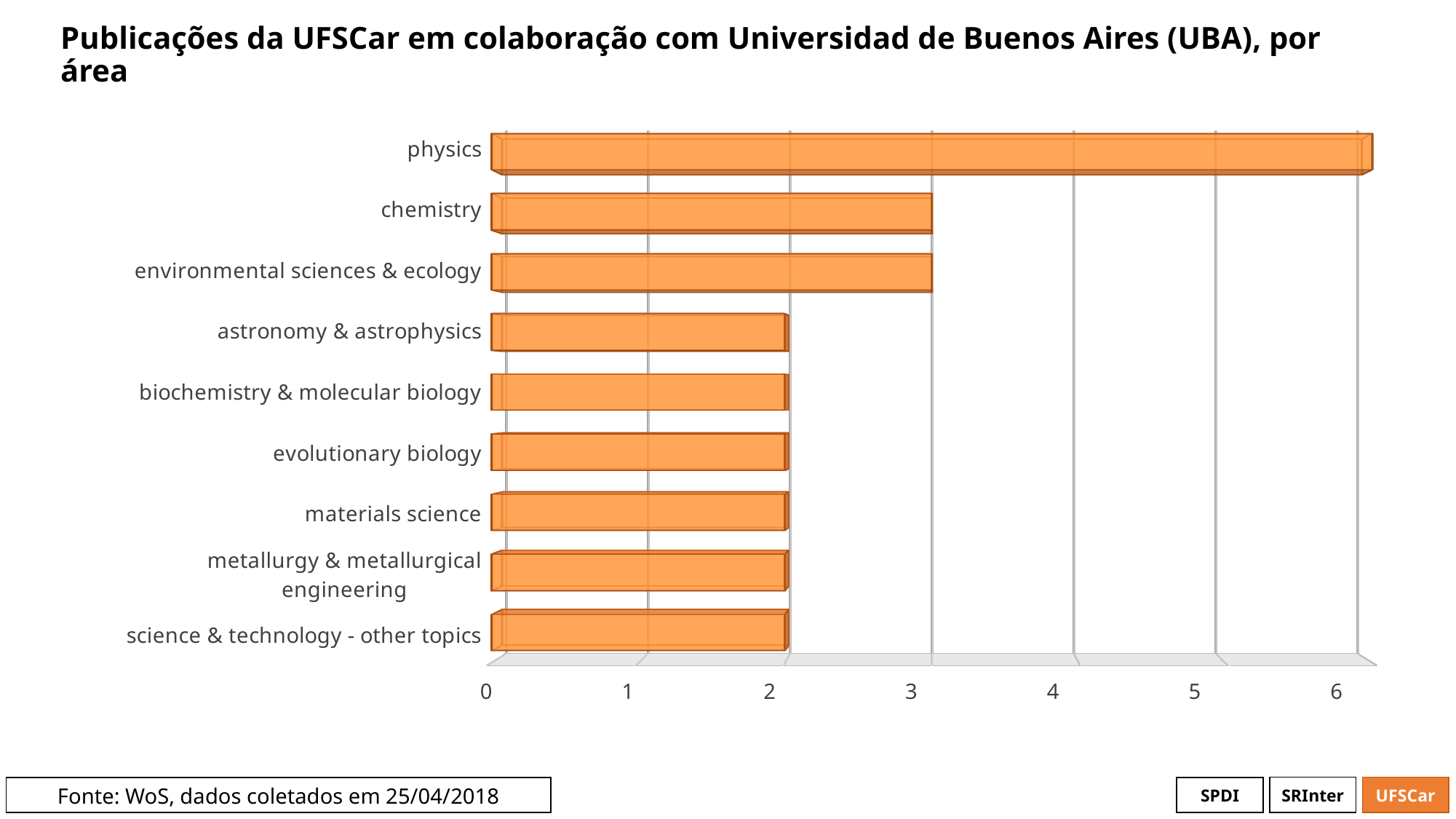
Is the value for environmental sciences & ecology greater or less than 2? greater Which is larger, the value for chemistry or the value for evolutionary biology? chemistry How many publications are shown for chemistry? 3 What is the title of the chart? Publicações da UFSCar em colaboração com Universidad de Buenos Aires (UBA), por área Which area has the highest number of publications? physics Is the value for physics greater or less than 5? greater What kind of chart is shown on the slide? bar chart How many publications are shown for physics? 6 Is the value for astronomy & astrophysics greater or less than 3? less What is the difference between the values for physics and chemistry? 3 How many areas are listed on the chart? 9 How many publications are shown for materials science? 2